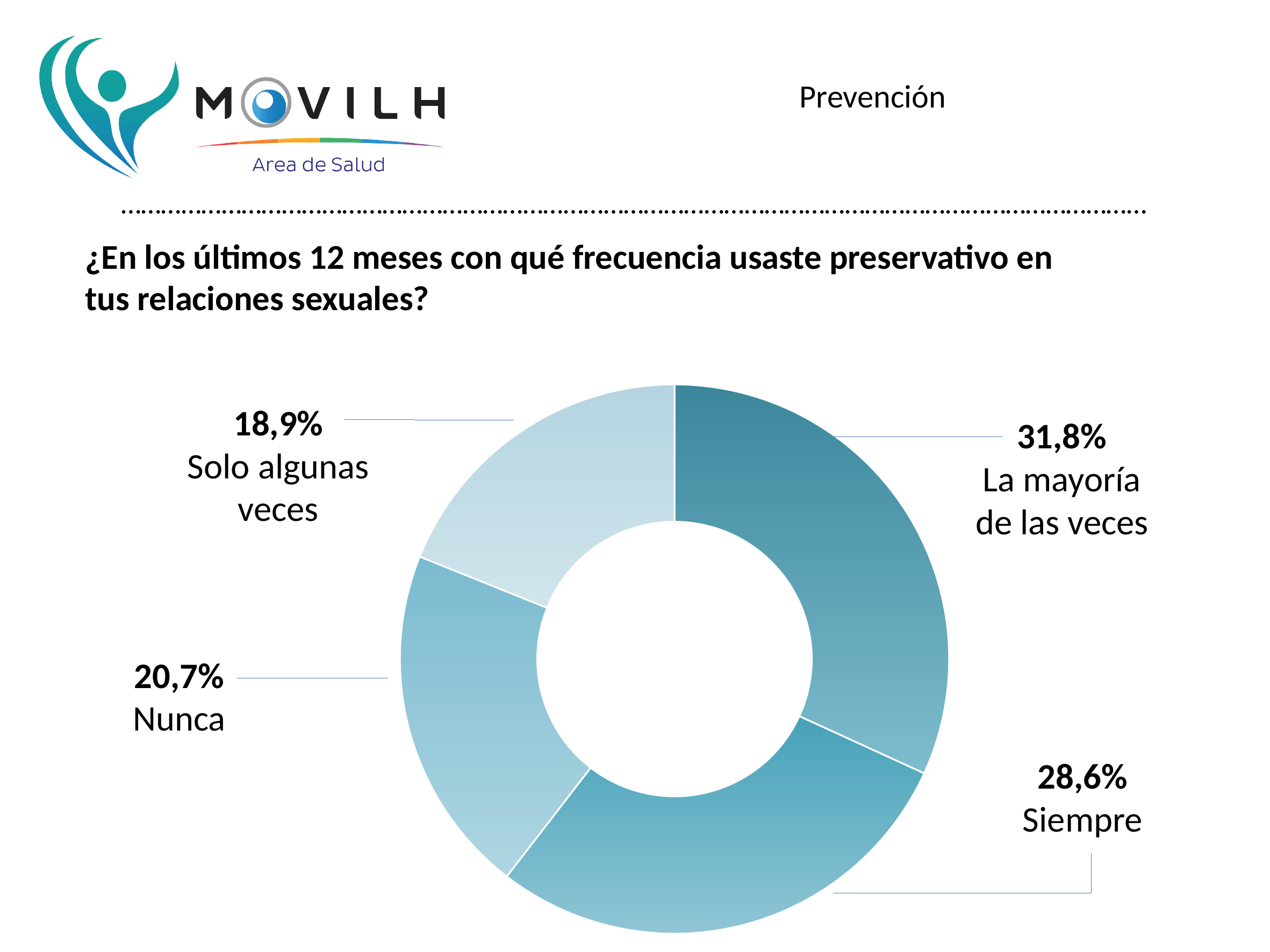
What percentage of respondents answered "Nunca"? 20,7% How many response categories are shown in the chart? 4 What percentage of respondents answered "Solo algunas veces"? 18,9% What is the difference in percentage points between "Nunca" and "Solo algunas veces"? 1,8 What percentage of respondents answered "La mayoría de las veces"? 31,8% Which response category has the smallest share? Solo algunas veces Which response category has the largest share? La mayoría de las veces What kind of chart is shown on the slide? Doughnut chart Which is larger, the share for "Siempre" or the share for "Nunca"? Siempre What percentage of respondents answered "Siempre"? 28,6% What is the difference in percentage points between "La mayoría de las veces" and "Siempre"? 3,2 What question does the chart on the slide present results for? ¿En los últimos 12 meses con qué frecuencia usaste preservativo en tus relaciones sexuales?